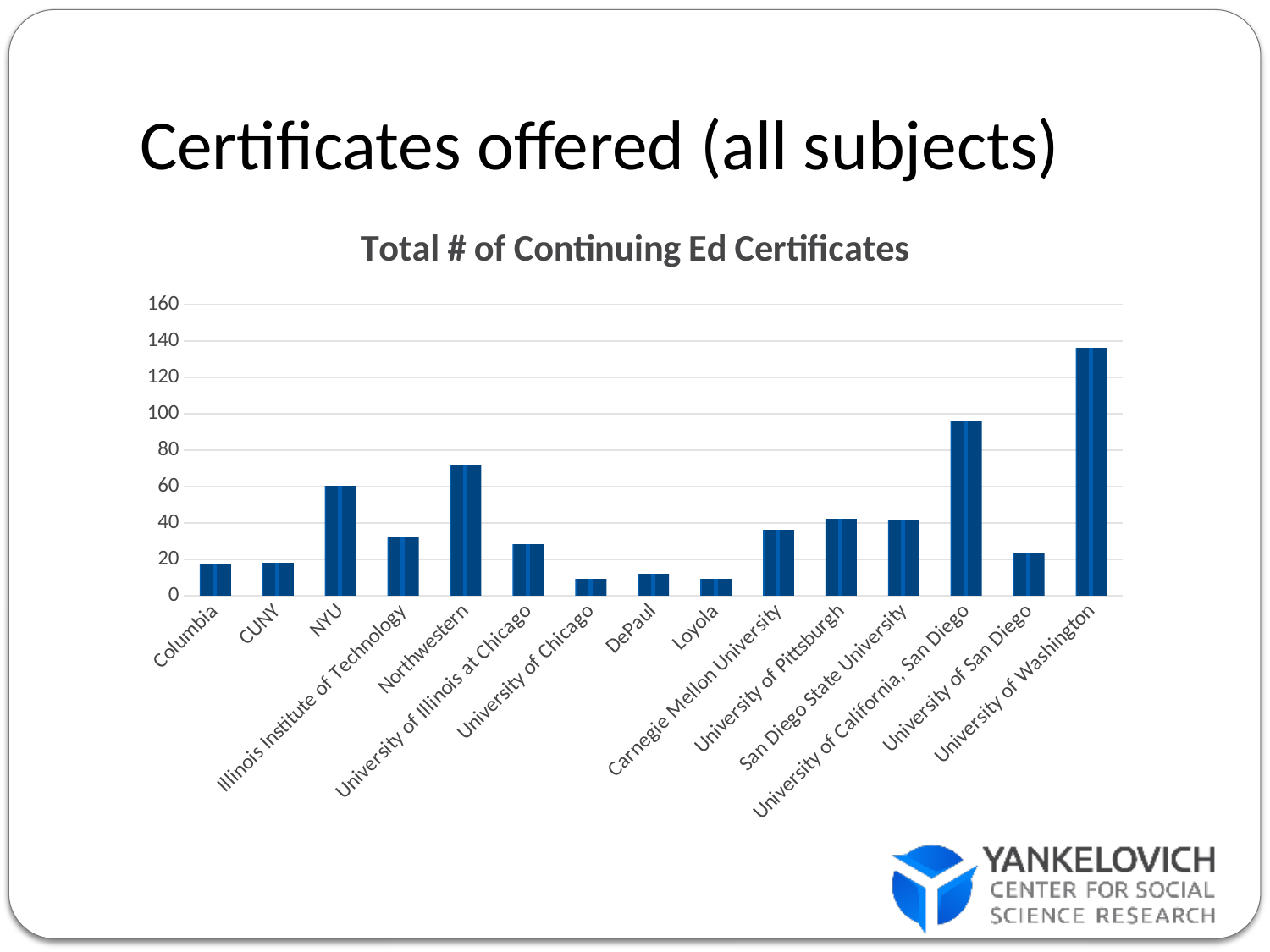
What type of chart is shown on the slide? bar chart How many universities are shown on the x axis of the chart? 15 What is the title of the chart? Total # of Continuing Ed Certificates Which has more continuing ed certificates, University of California, San Diego or Northwestern? University of California, San Diego Is the value for Carnegie Mellon University greater or less than 40? less Is the value for University of Washington greater or less than 120? greater Is the value for Columbia greater or less than 20? less Which university has the highest number of continuing ed certificates? University of Washington Which has more continuing ed certificates, NYU or DePaul? NYU